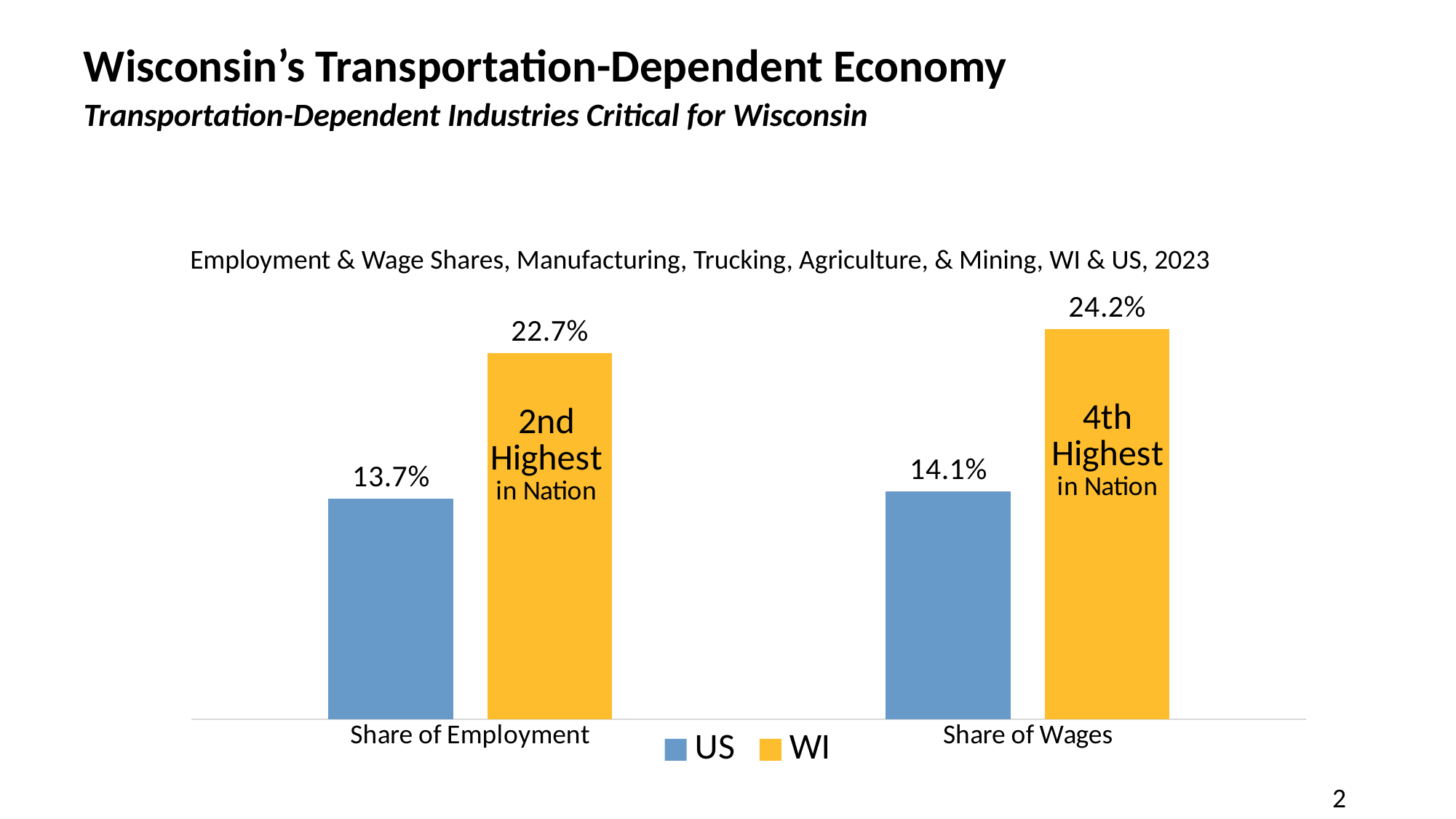
What is the WI value for Share of Employment? 22.7% How many categories are shown on the x axis? 2 How many series does the legend list? 2 What is the US value for Share of Employment? 13.7% Which bar has the highest value on the chart? WI, Share of Wages What is the US value for Share of Wages? 14.1% What kind of chart is shown on the slide? Bar chart What is the WI value for Share of Wages? 24.2% Which is larger for Share of Wages, the US value or the WI value? WI What is the difference between the WI and US values for Share of Wages? 10.1% Which bar has the lowest value on the chart? US, Share of Employment What is the difference between the WI and US values for Share of Employment? 9.0%